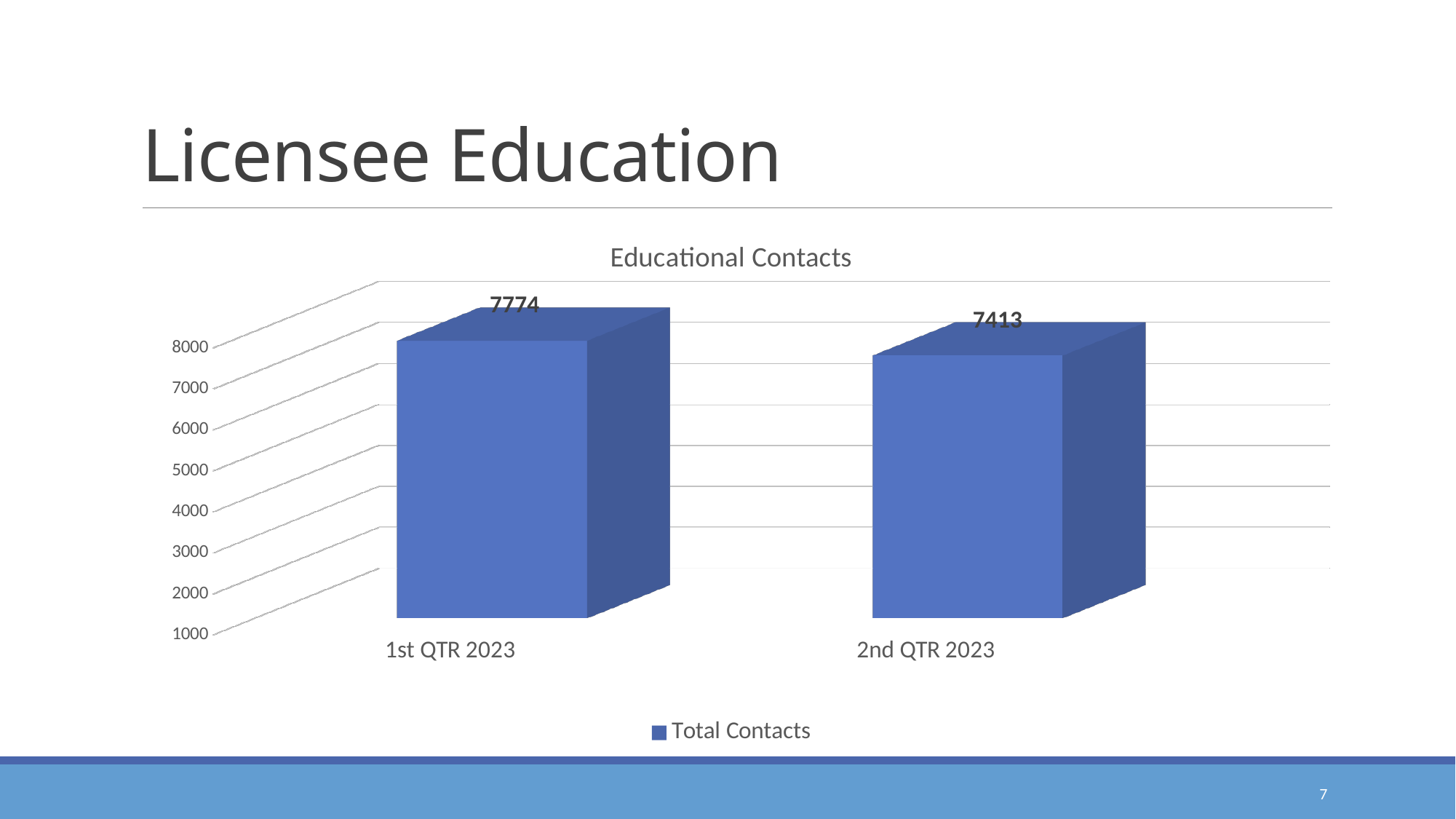
Which quarter has the lowest number of Total Contacts? 2nd QTR 2023 What is the difference between the Total Contacts for 1st QTR 2023 and 2nd QTR 2023? 361 How many series does the legend list? 1 Do the values rise or fall from 1st QTR 2023 to 2nd QTR 2023? Fall Is the value for 2nd QTR 2023 greater or less than 7000? greater Which is larger, the value for 1st QTR 2023 or 2nd QTR 2023? 1st QTR 2023 How many categories are shown on the x axis of the chart? 2 What is the value for 1st QTR 2023 in the Educational Contacts chart? 7774 What is the title of the chart? Educational Contacts What is the value for 2nd QTR 2023 in the Educational Contacts chart? 7413 Which quarter has the highest number of Total Contacts? 1st QTR 2023 What kind of chart is shown on the slide? Bar chart